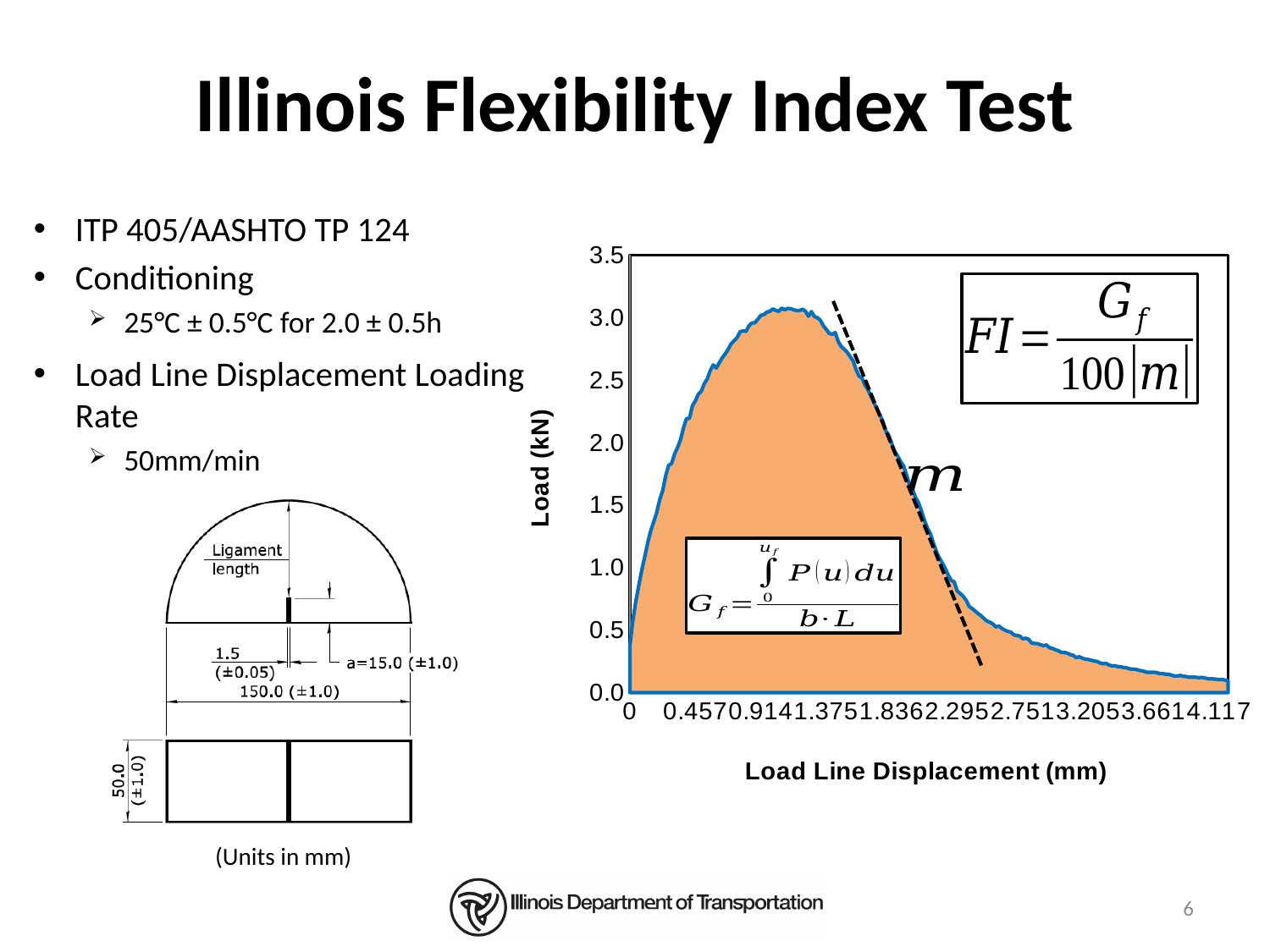
Is the load at a displacement of 4.117 mm greater or less than 0.5 kN? less Between a displacement of 0 and 0.914 mm, does the load rise or fall? rise What is the title of the vertical axis of the chart? Load (kN) What is the largest displacement value labelled on the horizontal axis? 4.117 Is the peak load on the chart greater or less than 2.5 kN? greater After reaching its peak, does the load rise or fall as displacement increases? fall Is the load at a displacement of 3.205 mm greater or less than 1.0 kN? less How many tick labels are shown on the horizontal axis? 10 What is the title of the horizontal axis of the chart? Load Line Displacement (mm) What is the highest value labelled on the vertical axis? 3.5 What kind of chart is shown on the slide? area chart